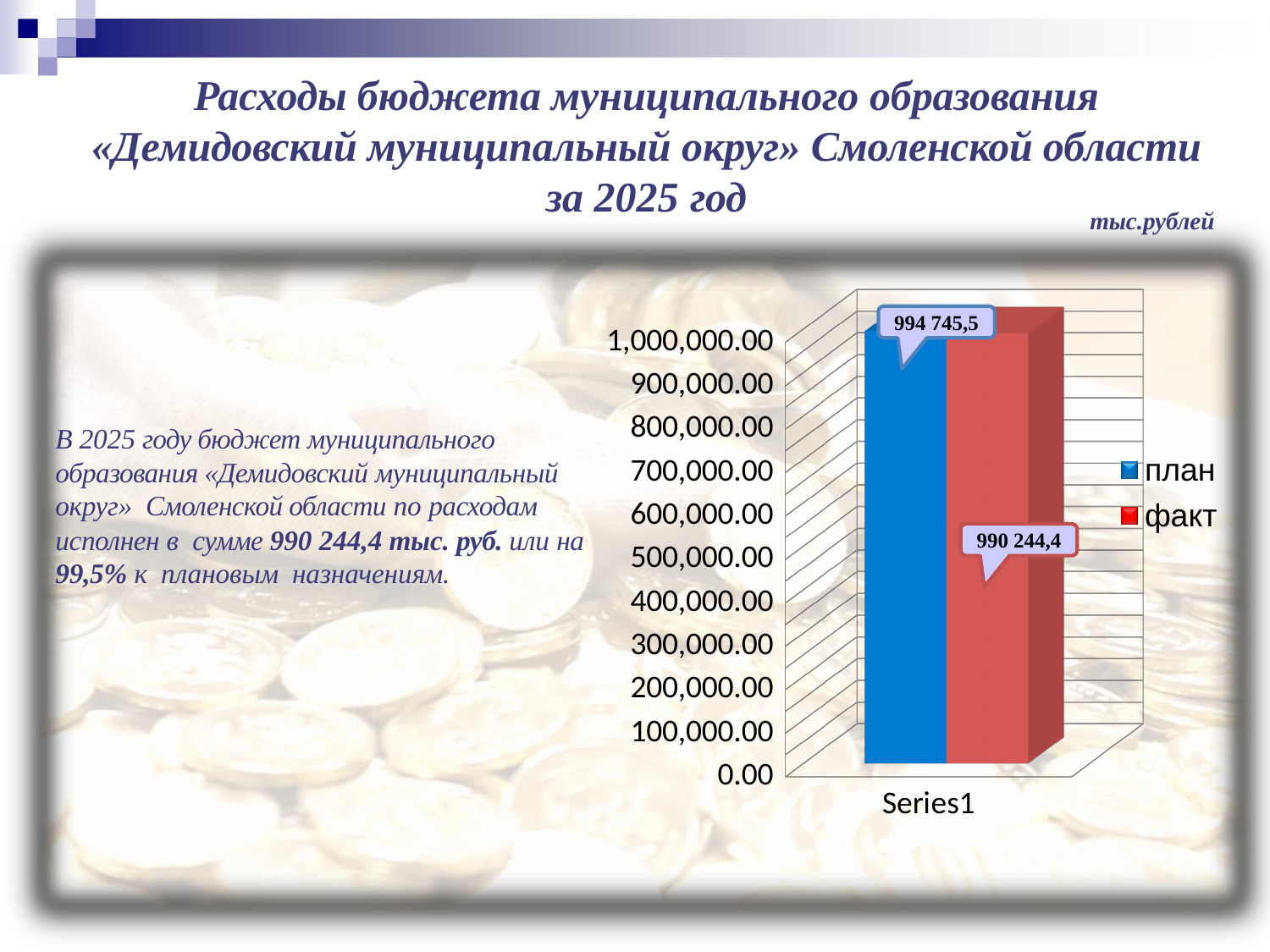
Is the value for план greater or less than 1,000,000.00? less Which series has the lowest value in the chart? факт What unit of measurement is indicated for the chart values? тыс.рублей Which series has the higher value, план or факт? план What type of chart is shown on the slide? bar chart How many series does the legend list? 2 What is the value of the план (plan) bar? 994 745,5 Is the value for факт greater or less than 900,000.00? greater What colour is the план series in the chart? blue What is the value of the факт (actual) bar? 990 244,4 How many categories are shown on the x axis? 1 What is the difference between the план value and the факт value? 4 501,1